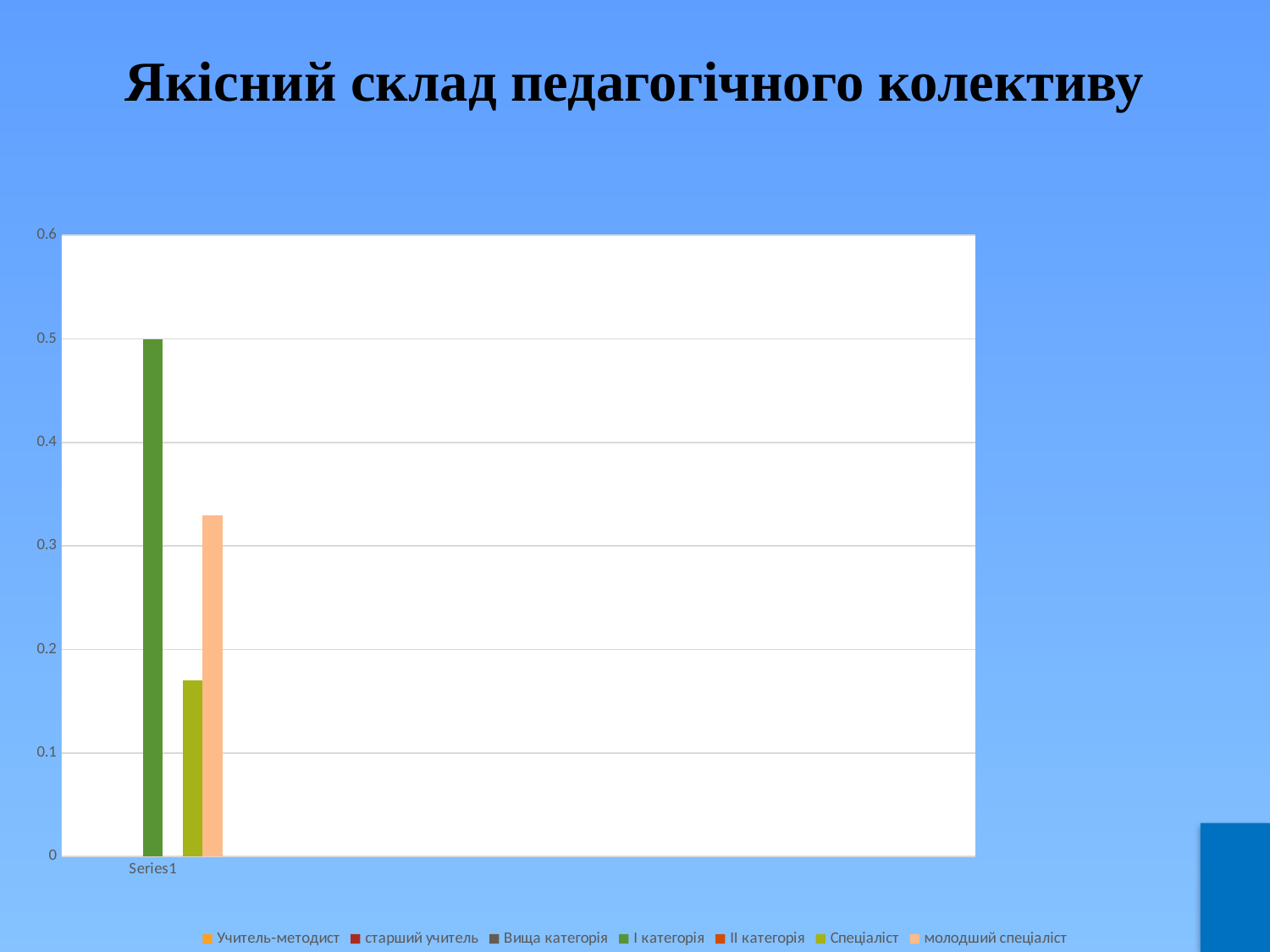
What is the value of the І категорія bar? 0.5 How many bars are plotted in the chart? 3 Is the value for молодший спеціаліст greater or less than 0.4? less How many series does the legend list? 7 What kind of chart is shown on the slide? bar chart Which series has the tallest bar? І категорія What is the title of the slide? Якісний склад педагогічного колективу Which is larger, the value for молодший спеціаліст or the value for Спеціаліст? молодший спеціаліст Is the value for Спеціаліст greater or less than 0.2? less What is the label shown on the category axis? Series1 Is the value for молодший спеціаліст greater or less than 0.3? greater Which of the three plotted bars is the shortest? Спеціаліст